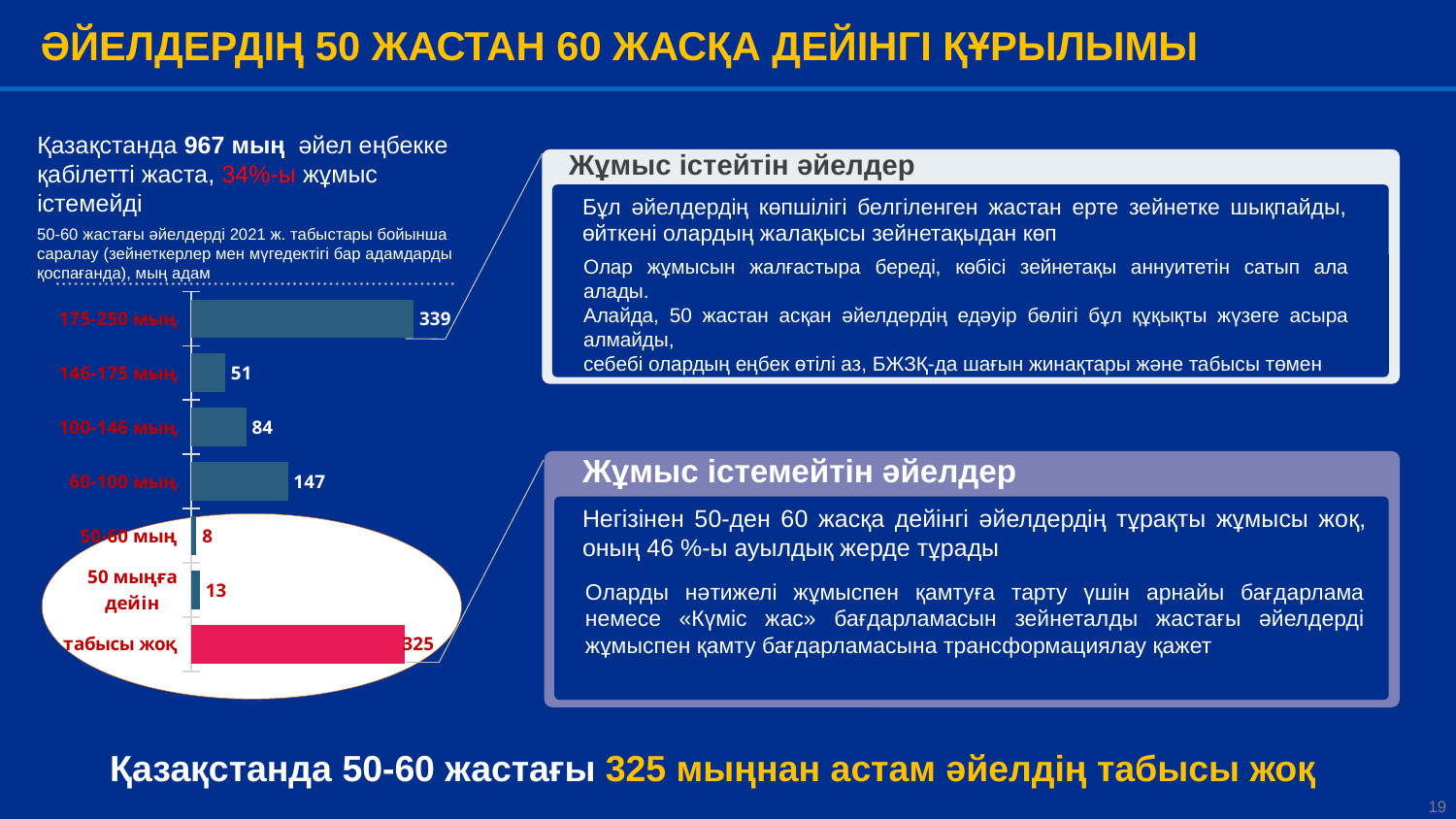
What is the value for the category "175-250 мың"? 339 What is the difference between the values for "60-100 мың" and "100-146 мың"? 63 What is the value for the category "табысы жоқ"? 325 How many categories are shown in the bar chart? 7 What is the difference between the values for "175-250 мың" and "табысы жоқ"? 14 Which category has the lowest value? 50-60 мың What kind of chart is shown on the slide? Bar chart What is the value for the category "50 мыңға дейін"? 13 Which category has the highest value? 175-250 мың What unit is stated in the chart title for the plotted values? мың адам What is the value for the category "60-100 мың"? 147 Which is larger, the value for "146-175 мың" or the value for "100-146 мың"? 100-146 мың